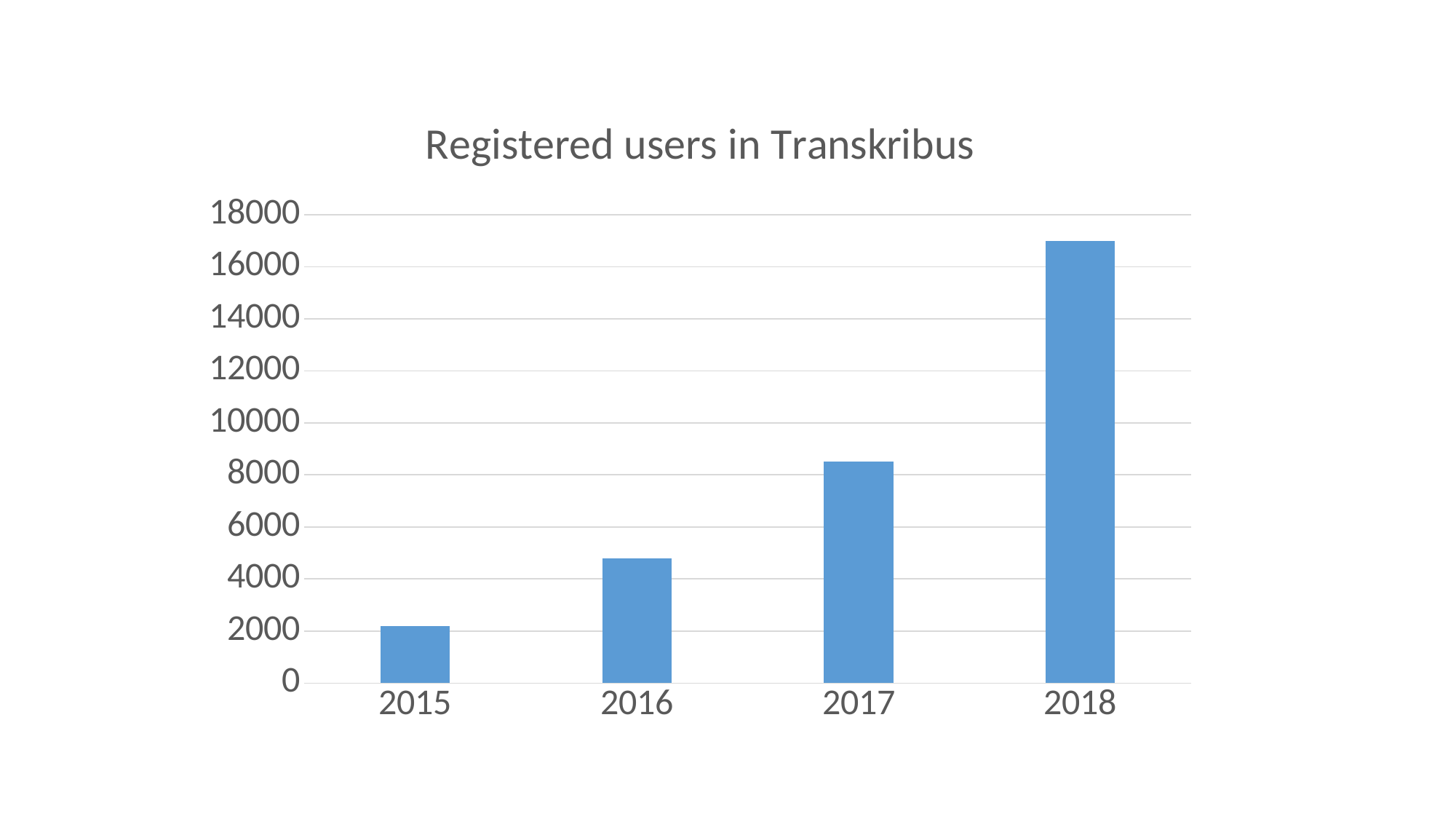
Is the value for 2015 greater or less than 4000? less What type of chart is shown on the slide? bar chart Is the value for 2017 greater or less than 10000? less Do the values rise or fall from 2015 to 2018? rise How many years are shown on the x axis of the chart? 4 What is the maximum value shown on the y axis? 18000 Is the value for 2018 greater or less than 16000? greater What is the title of the chart? Registered users in Transkribus Which is larger, the value for 2016 or the value for 2017? 2017 Which year has the highest number of registered users? 2018 Which year has the lowest number of registered users? 2015